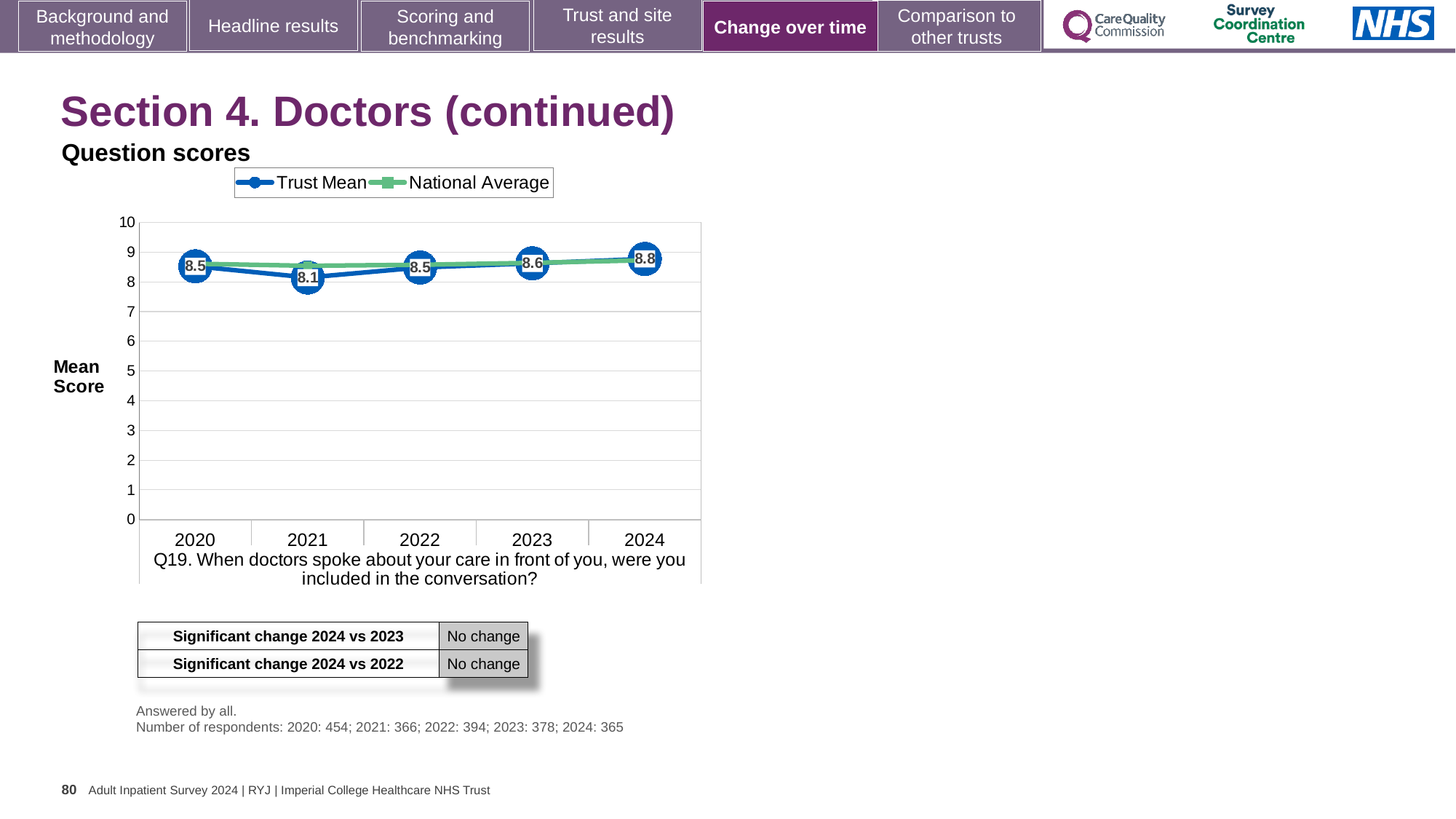
What is the Trust Mean score for 2023? 8.6 In which year is the Trust Mean highest? 2024 How many series does the legend list? 2 Is the National Average value for 2021 greater or less than 8? greater Which year has the larger Trust Mean, 2021 or 2023? 2023 How many years are plotted on the x axis? 5 What is the difference between the Trust Mean in 2024 and in 2021? 0.7 In which year is the Trust Mean lowest? 2021 What is the Trust Mean score for 2024? 8.8 What is the Trust Mean score for 2021? 8.1 Does the Trust Mean rise or fall from 2021 to 2024? Rise What kind of chart is shown? Line chart